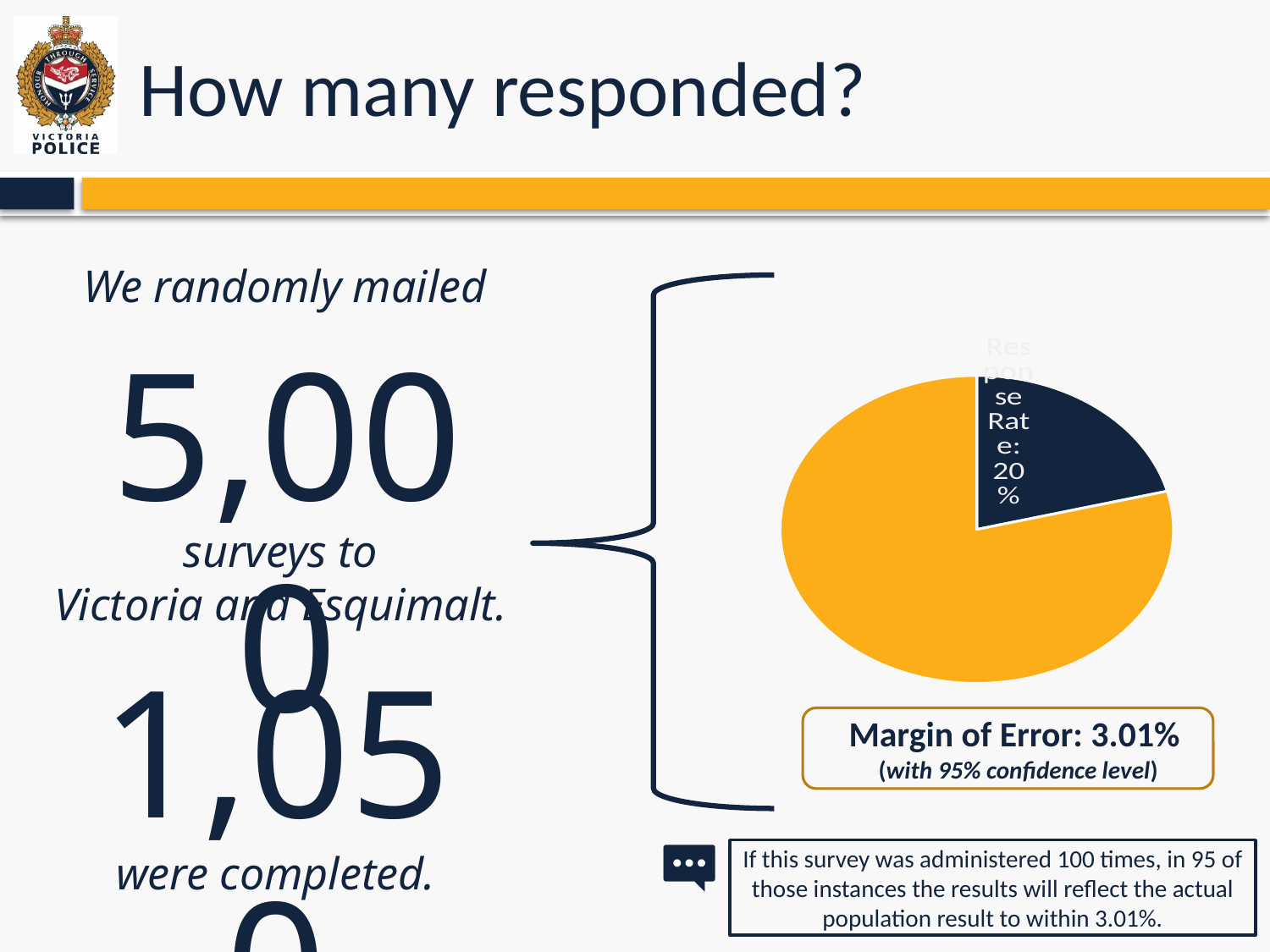
Which slice of the pie chart is larger, the yellow slice or the dark navy slice? the yellow slice What colour is the largest slice of the pie chart? yellow What share of the pie does the Response Rate slice represent? 20% What colour is the slice labelled Response Rate in the pie chart? dark navy blue Which slice of the pie chart is the smallest? Response Rate: 20% Is the Response Rate slice of the pie chart greater or less than 50% of the pie? less How many slices does the pie chart have? 2 What is the value shown on the data label of the dark slice in the pie chart? 20% What kind of chart is shown on the slide? pie chart